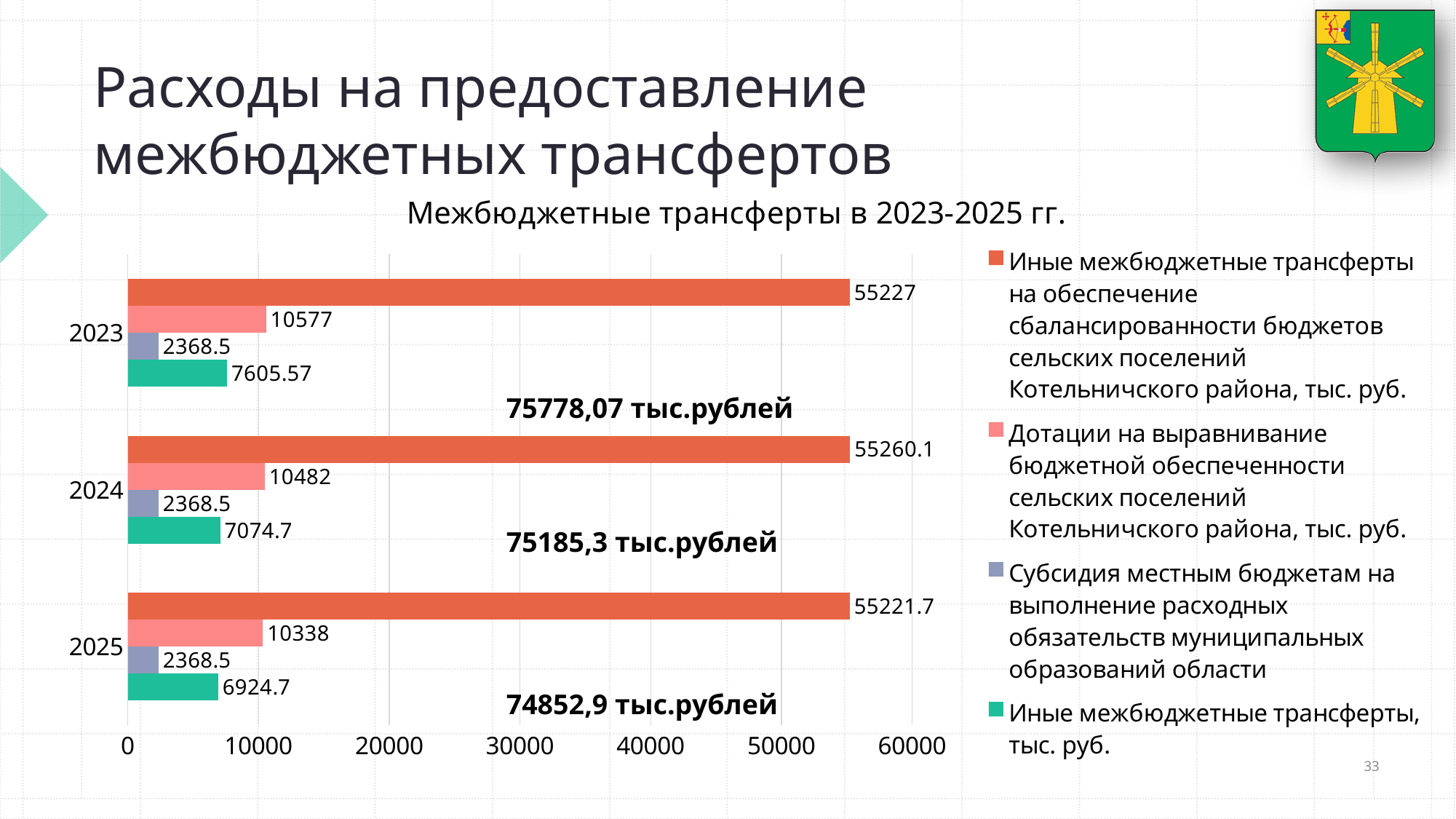
Which is larger: the green series «Иные межбюджетные трансферты, тыс. руб.» in 2023 or in 2024? 2023 What is the value of «Дотации на выравнивание бюджетной обеспеченности сельских поселений» for 2024? 10482 What is the value of «Иные межбюджетные трансферты, тыс. руб.» (green series) for 2025? 6924.7 In which year is the value of «Иные межбюджетные трансферты, тыс. руб.» (green series) the lowest? 2025 Does the value of «Дотации на выравнивание бюджетной обеспеченности сельских поселений» rise or fall from 2023 to 2025? Fall What is the value of «Субсидия местным бюджетам на выполнение расходных обязательств муниципальных образований области» for 2023? 2368.5 In which year is the value of «Дотации на выравнивание бюджетной обеспеченности сельских поселений» the highest? 2023 How many series does the legend list? 4 What total is printed on the chart for 2024? 75185,3 тыс.рублей How many years (categories) are shown on the chart? 3 What is the difference between the 2023 and 2025 values of «Дотации на выравнивание бюджетной обеспеченности сельских поселений»? 239 What kind of chart is shown on the slide? Bar chart